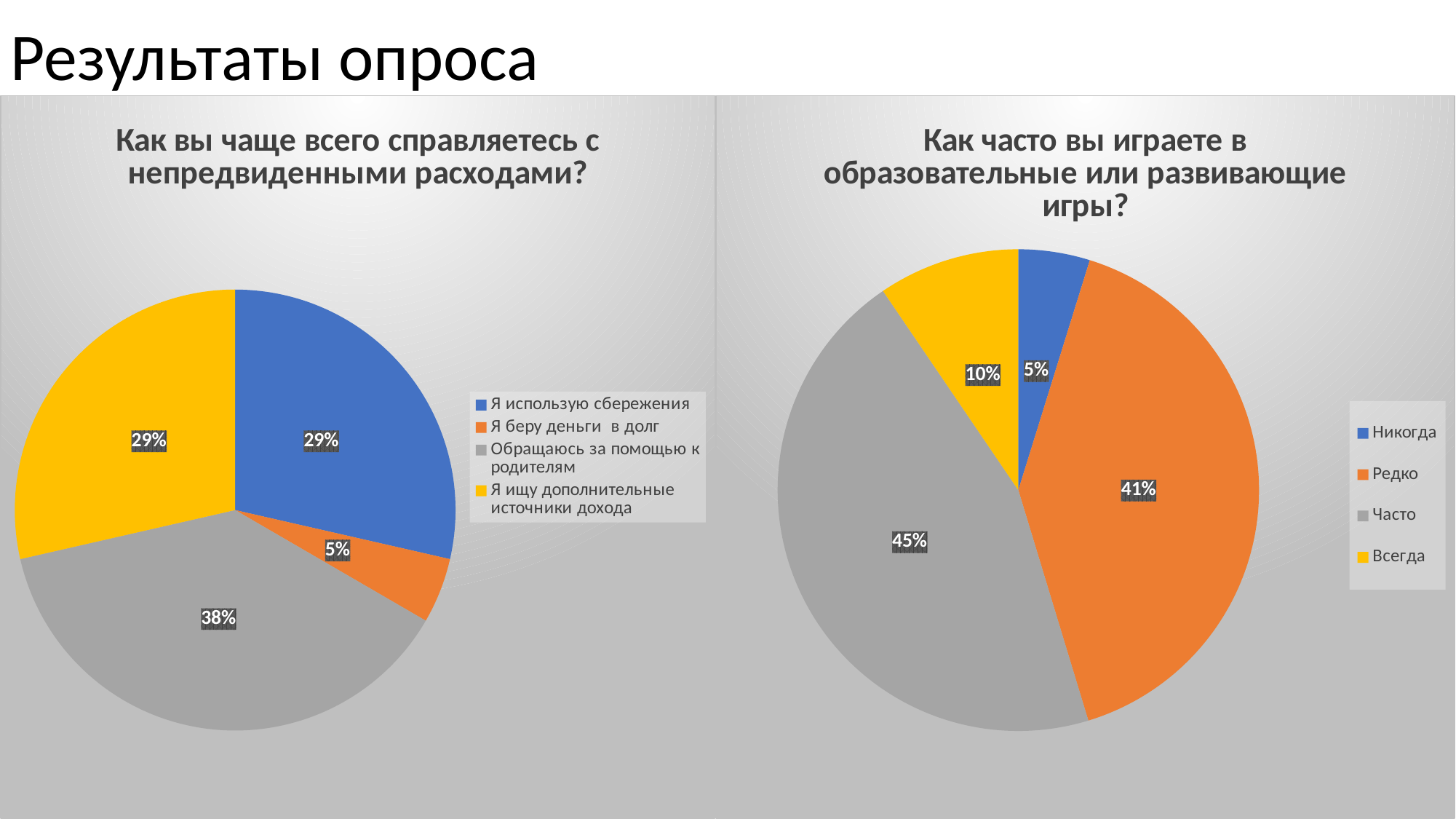
In the left chart, which category has the largest share? Обращаюсь за помощью к родителям How many categories does the legend of the left chart list? 4 In the right chart ("Как часто вы играете в образовательные или развивающие игры?"), what share of respondents answered "Редко"? 41% What type of chart is used on the right side of the slide? Pie chart In the left chart, which category has the smallest share? Я беру деньги в долг In the right chart, which answer has the largest share? Часто In the left chart, what percentage is shown for "Я беру деньги в долг"? 5% In the left chart ("Как вы чаще всего справляетесь с непредвиденными расходами?"), what share of respondents answered "Обращаюсь за помощью к родителям"? 38% In the left chart, what is the difference in percentage points between "Обращаюсь за помощью к родителям" and "Я использую сбережения"? 9 In the right chart, which is larger: the share for "Часто" or the share for "Редко"? Часто In the right chart, which answer has the smallest share? Никогда In the right chart, what percentage is shown for "Всегда"? 10%